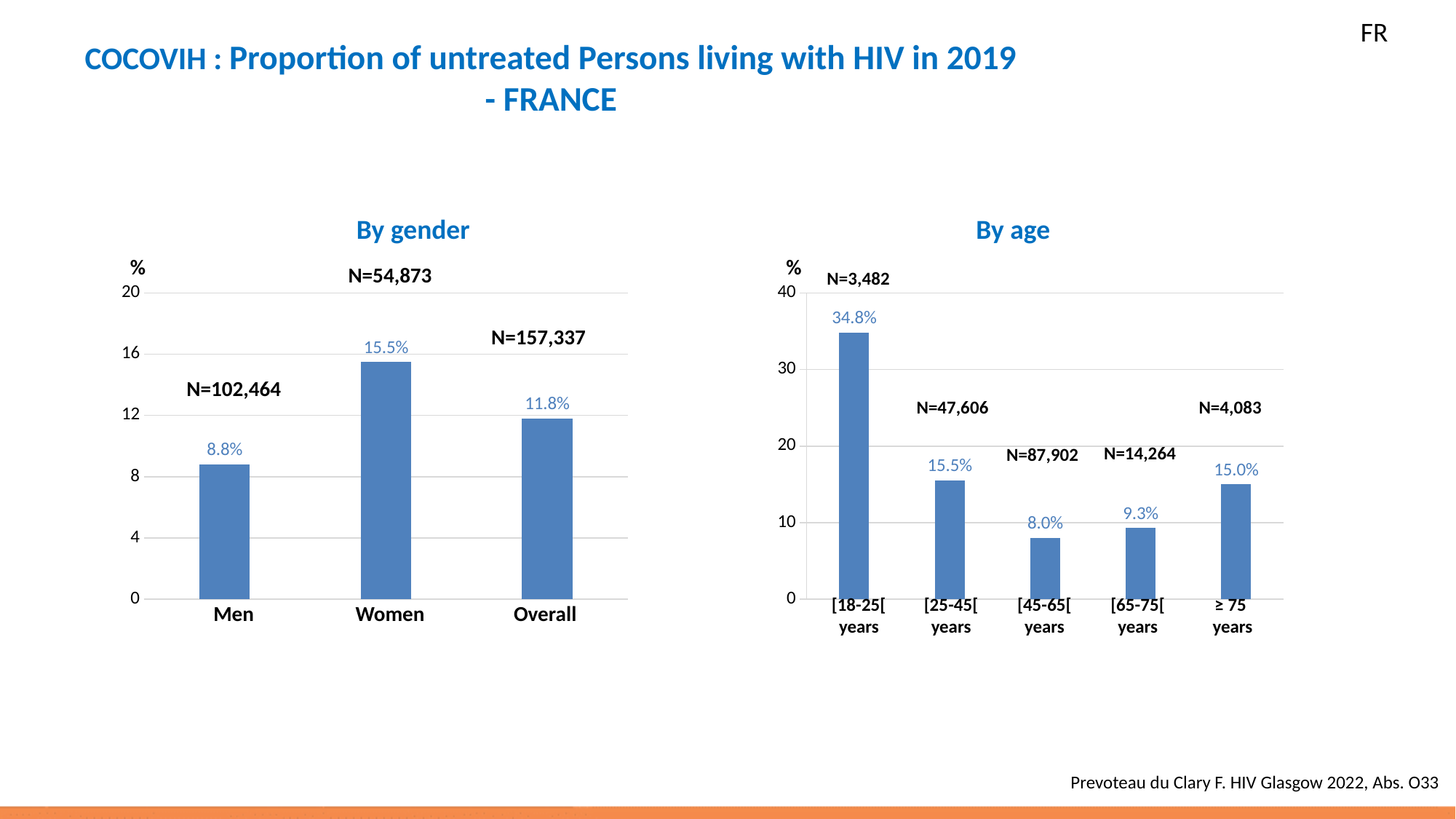
In the 'By age' chart, which age group has the lowest value? [45-65[ years In the 'By age' chart, what is the value for [18-25[ years? 34.8% In the 'By gender' chart, which category has the highest value? Women In the 'By gender' chart, what is the value for Women? 15.5% In the 'By gender' chart, what is the value for Men? 8.8% In the 'By gender' chart, what is the difference between the values for Women and Men? 6.7% In the 'By gender' chart, how many categories are shown on the x axis? 3 In the 'By age' chart, which is larger, the value for [65-75[ years or the value for ≥ 75 years? ≥ 75 years In the 'By age' chart, how many age groups are shown? 5 In the 'By age' chart, is the value for [18-25[ years greater or less than 30? greater What kind of chart is the 'By age' chart? Bar chart In the 'By gender' chart, what is the N value shown above the Overall bar? N=157,337